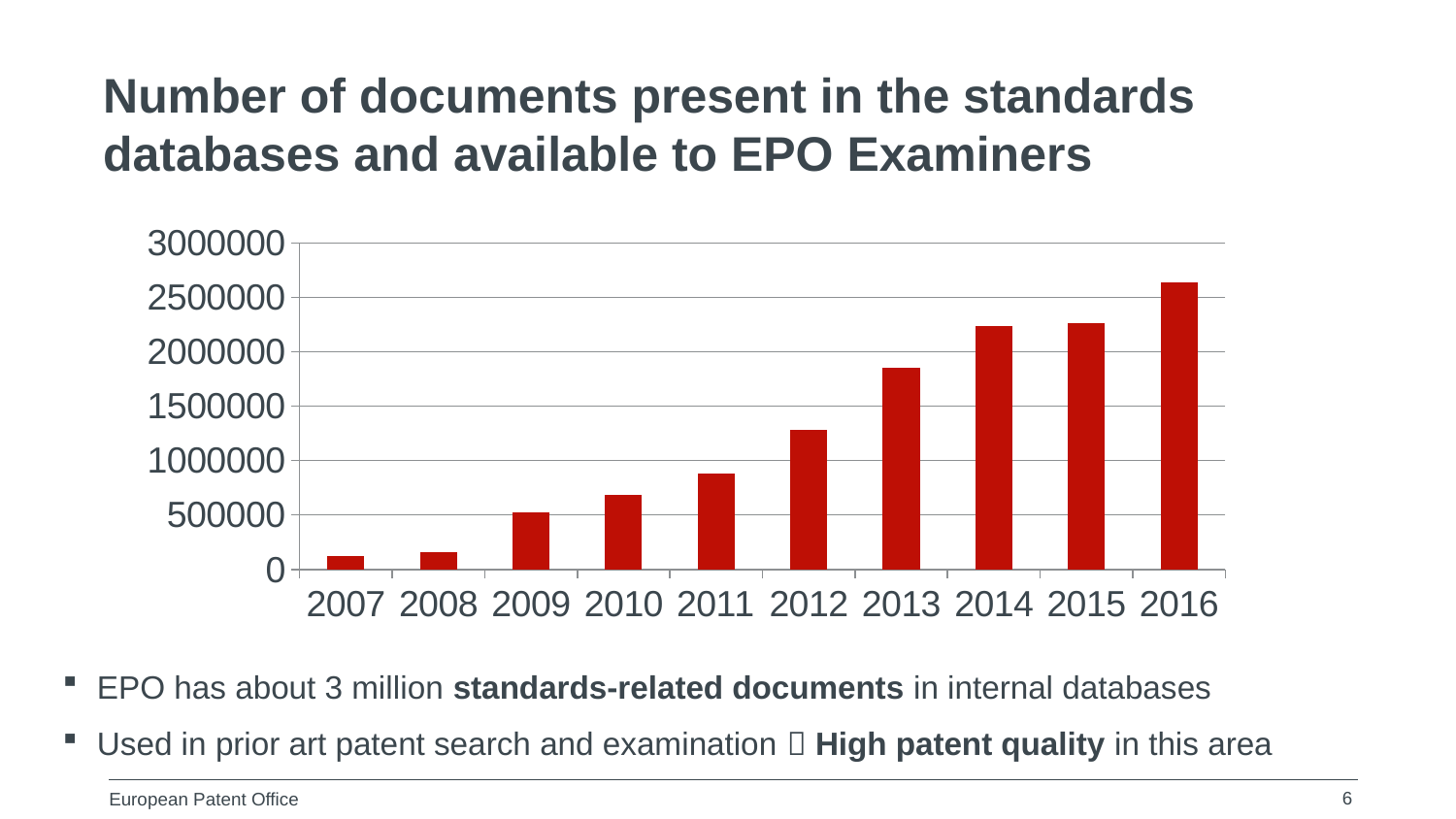
What kind of chart is shown on the slide? bar chart Is the value for 2011 greater or less than 1000000? less Which year has the highest number of documents? 2016 Is the value for 2012 greater or less than 1000000? greater How many years are shown on the x axis of the chart? 10 Is the value for 2013 greater or less than 2000000? less Do the values generally rise or fall from 2007 to 2016? rise What is the highest value shown on the y axis of the chart? 3000000 Which is larger, the value for 2013 or the value for 2012? 2013 Which year has the lowest number of documents? 2007